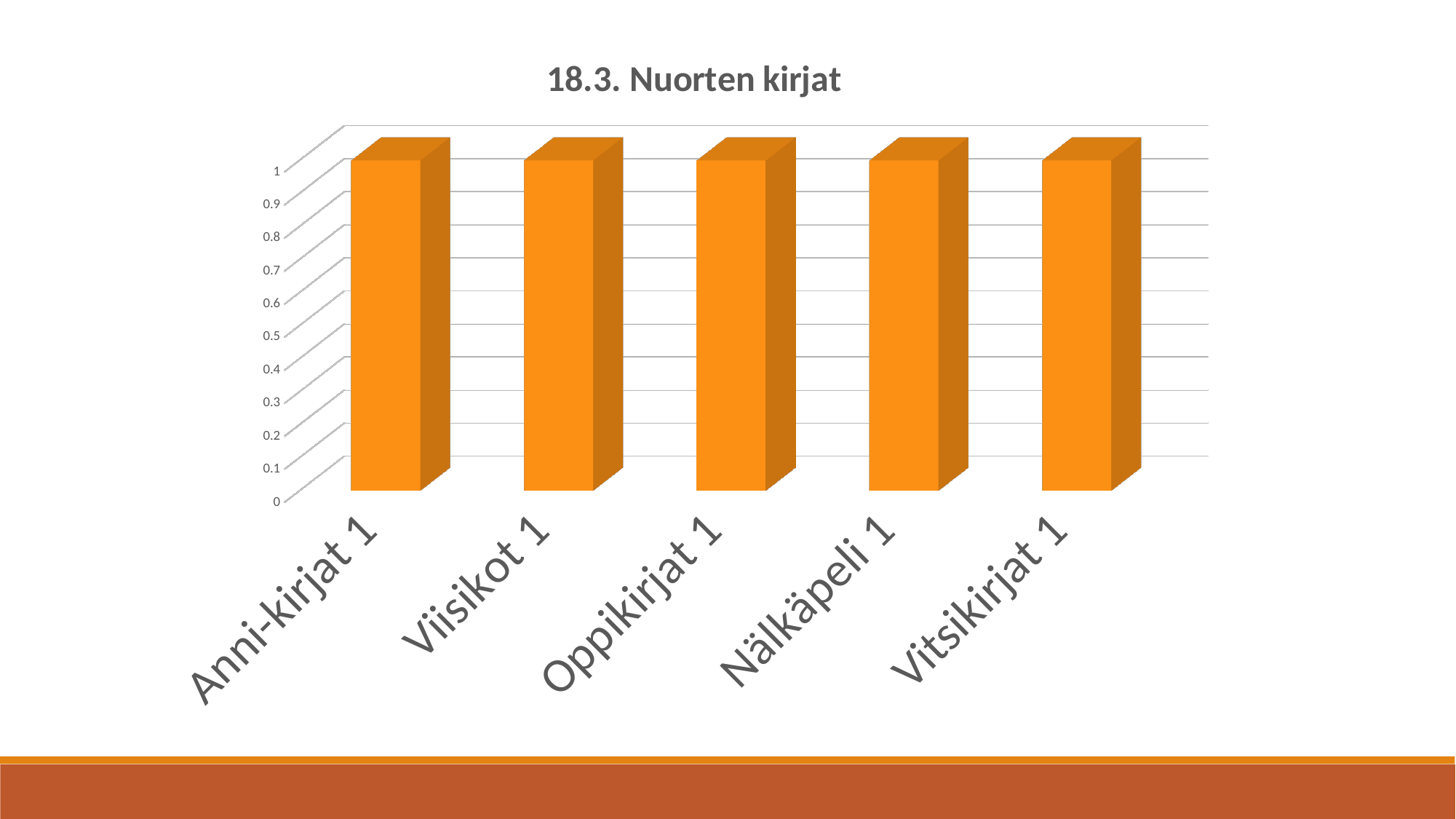
What is the value for Vitsikirjat 1? 1 What is the value for Anni-kirjat 1? 1 Do the values rise, fall, or stay the same across the categories from left to right? stay the same Is the value for Oppikirjat 1 greater or less than 0.5? greater What is the title of the chart? 18.3. Nuorten kirjat What is the difference between the values for Anni-kirjat 1 and Vitsikirjat 1? 0 What kind of chart is shown on the slide? bar chart Is the value for Nälkäpeli 1 greater or less than 0.8? greater How many categories are shown on the x axis of the chart? 5 What is the value for Viisikot 1? 1 What is the value for Nälkäpeli 1? 1 What colour are the bars in the chart? orange